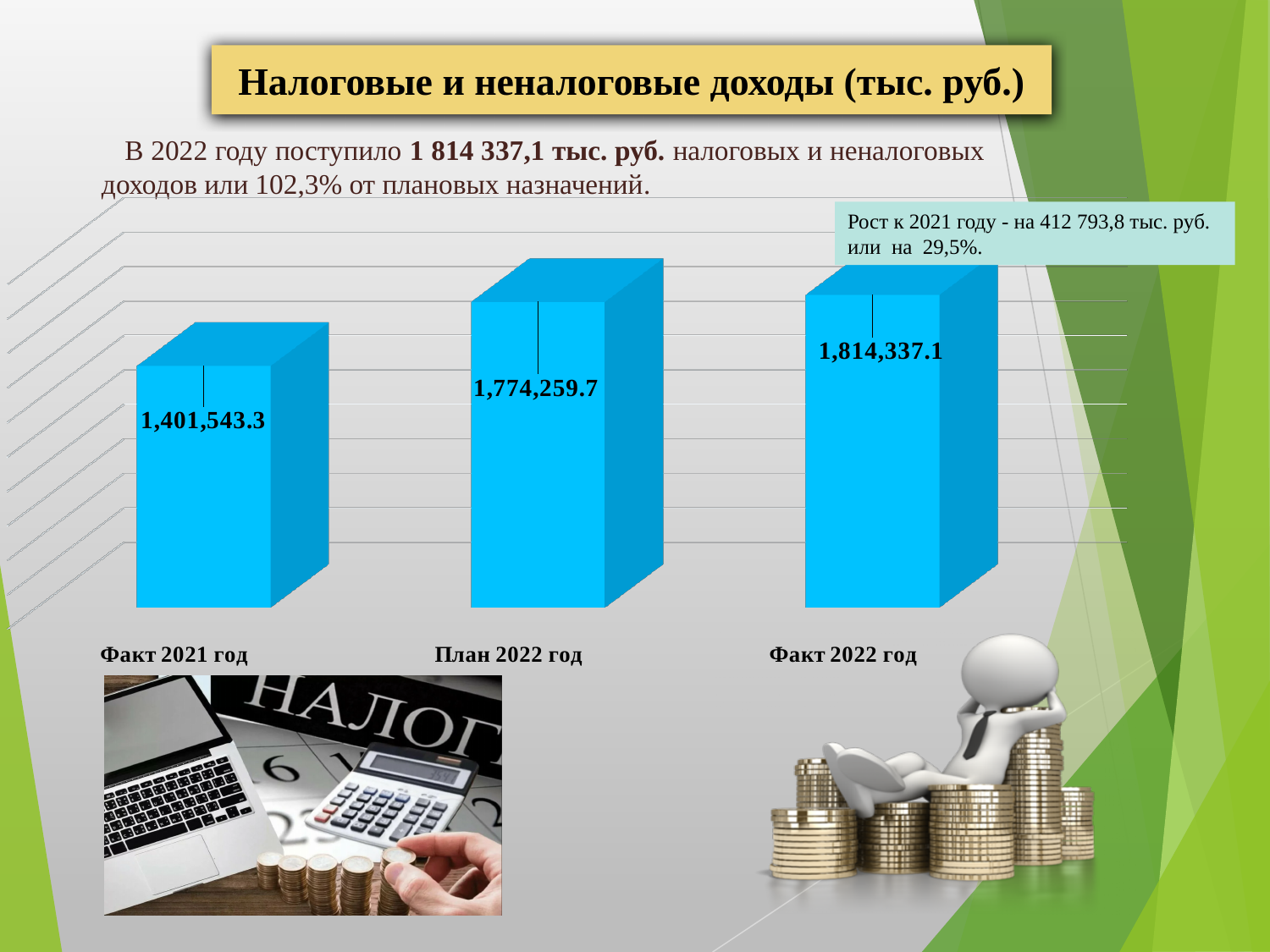
Which category has the highest value? Факт 2022 год Which category has the lowest value? Факт 2021 год What kind of chart is shown on the slide? Bar chart What is the difference between the values for Факт 2022 год and Факт 2021 год? 412,793.8 What is the value for Факт 2022 год? 1,814,337.1 Do the values rise or fall from left to right across the categories? Rise What is the difference between the values for План 2022 год and Факт 2021 год? 372,716.4 How many categories are shown in the chart? 3 What is the value for План 2022 год? 1,774,259.7 Which is larger, the value for План 2022 год or the value for Факт 2022 год? Факт 2022 год What is the value for Факт 2021 год? 1,401,543.3 What is the difference between the values for Факт 2022 год and План 2022 год? 40,077.4